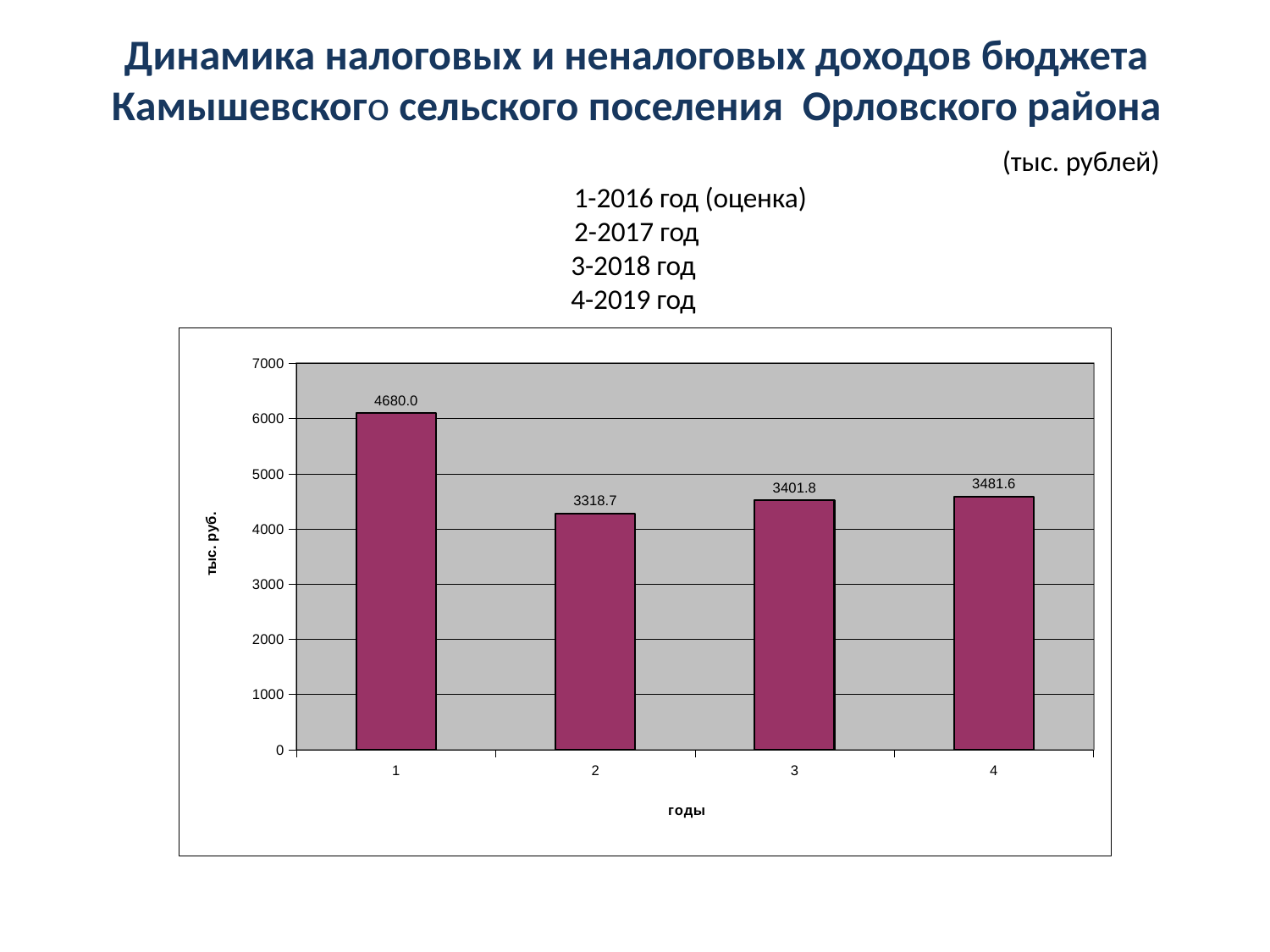
What is the value for category 2 (2017 год)? 3318.7 Which category has the highest value? 1 How many bars are plotted in the chart? 4 What kind of chart is shown on the slide? bar chart Which category has the lowest value? 2 What is the title of the vertical axis? тыс. руб. Which is larger, the value for category 3 or category 4? 4 Is the value for category 2 greater or less than 3000? greater What is the value for category 3 (2018 год)? 3401.8 What is the difference between the values for category 1 and category 2? 1361.3 What is the value for category 4 (2019 год)? 3481.6 What is the value for category 1 (2016 год, оценка)? 4680.0